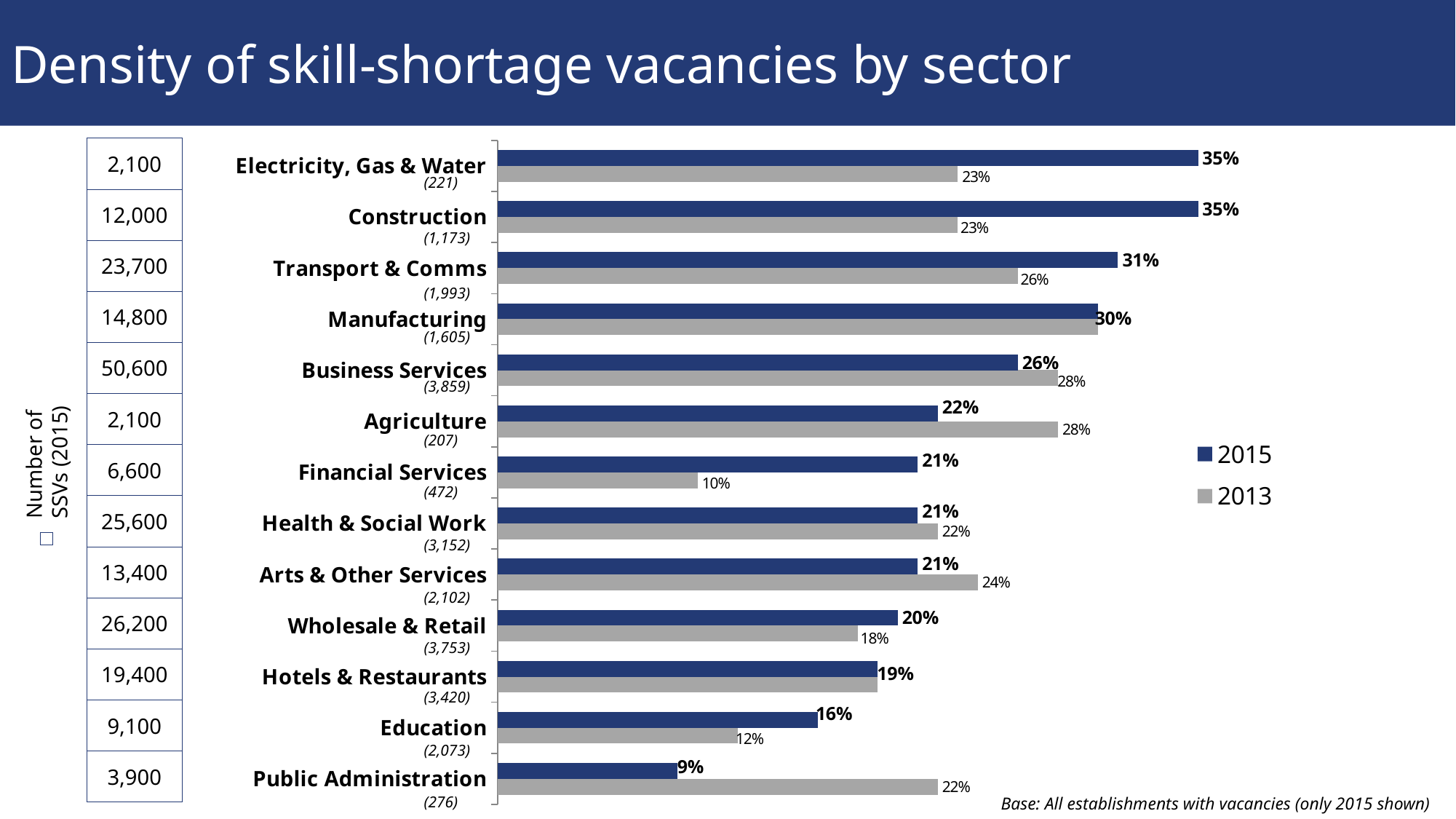
What type of chart is shown on the slide? Bar chart For Agriculture, which year has the higher value, 2015 or 2013? 2013 How many series does the legend list? 2 What is the 2015 value for Education? 16% What is the 2015 skill-shortage vacancy density for Transport & Comms? 31% What is the difference between the 2013 and 2015 values for Public Administration? 13 percentage points For Wholesale & Retail, which year has the higher value, 2015 or 2013? 2015 Which sector has the lowest 2015 value? Public Administration What is the 2013 value for Financial Services? 10% Which sector has the lowest 2013 value? Financial Services What is the difference between the 2015 and 2013 values for Financial Services? 11 percentage points How many sectors are shown in the chart? 13